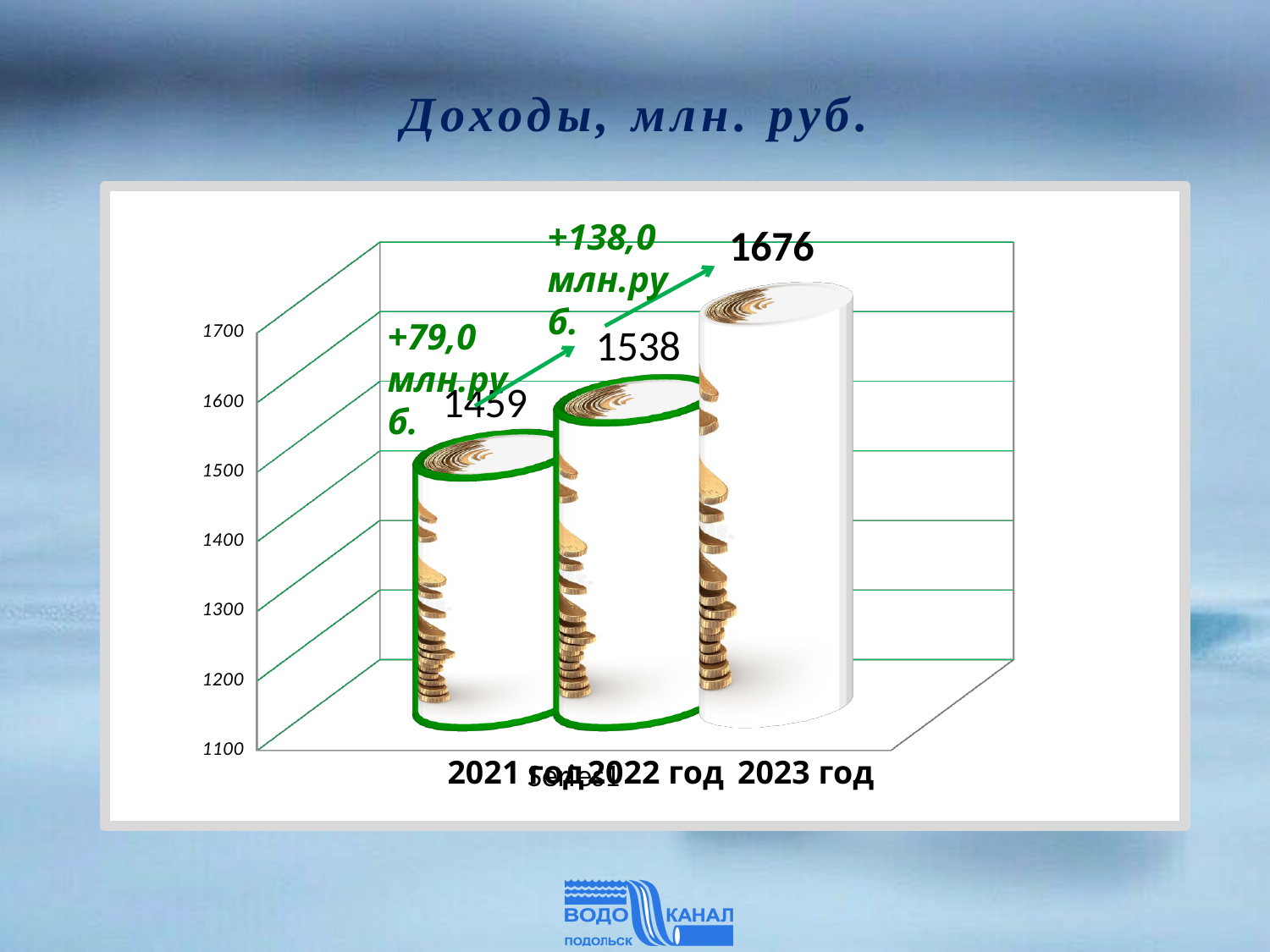
Do the values rise or fall from 2021 год to 2023 год? rise Which year has the highest value? 2023 год Is the value for 2021 год greater or less than 1500? less Which year has the lowest value? 2021 год What is the difference between the values for 2023 год and 2022 год? 138 How many years are shown on the chart? 3 What is the value for 2022 год? 1538 What is the value for 2023 год? 1676 What is the difference between the values for 2022 год and 2021 год? 79 What kind of chart is shown on the slide? bar chart What is the value for 2021 год? 1459 Which is larger, the value for 2021 год or the value for 2022 год? 2022 год